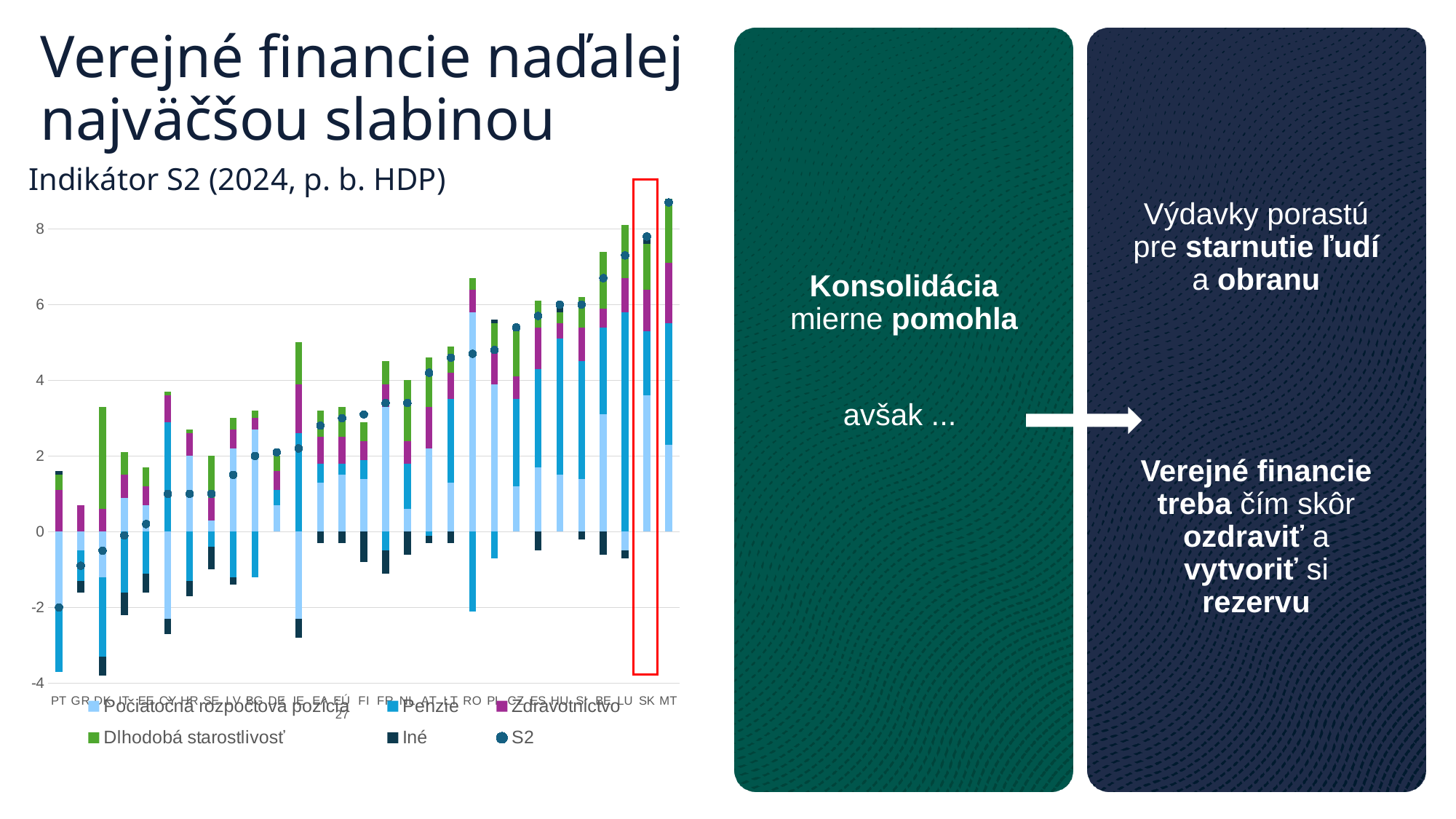
Which has the larger S2 value, SK or BE? SK How many series does the chart legend list? 6 Which country has the lowest S2 value? PT What is the title of the chart? Indikátor S2 (2024, p. b. HDP) Is the S2 value for SK greater or less than 6? greater Which country on the x axis is highlighted with a red box? SK Which country has the highest S2 value? MT Is the S2 value for PT greater or less than 0? less Is the S2 value for MT greater or less than 8? greater What kind of chart is shown on the slide? bar chart Do the S2 values generally rise or fall from left to right along the x axis? rise